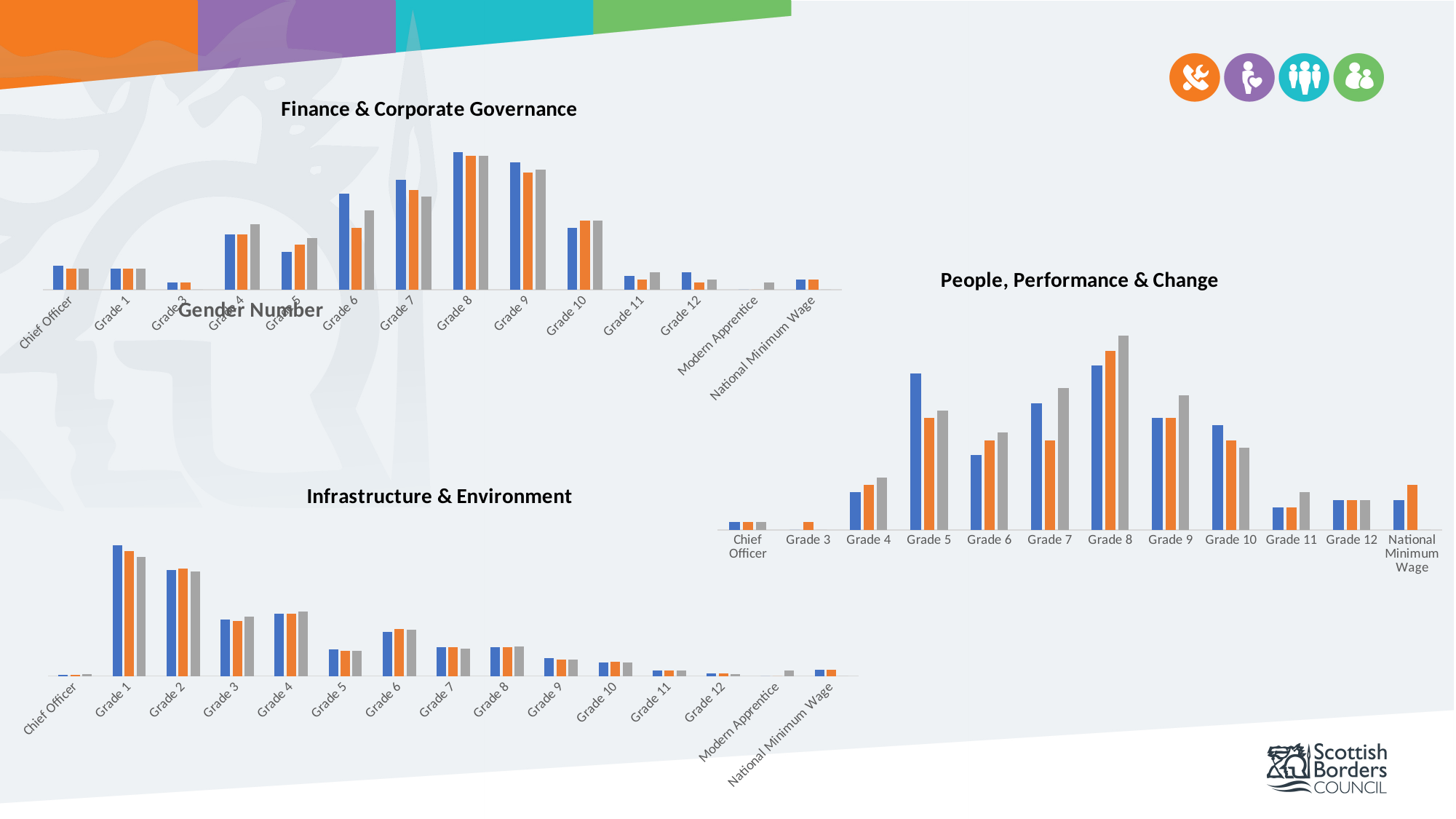
What kind of chart is the 'Finance & Corporate Governance' chart? bar chart In the 'Finance & Corporate Governance' chart, which is larger, the blue bar for Grade 8 or the blue bar for Grade 10? Grade 8 In the 'Finance & Corporate Governance' chart, which category has the tallest bar? Grade 8 How many charts are shown on the slide? 3 In the 'Infrastructure & Environment' chart, how many categories are shown on the x axis? 15 In the 'People, Performance & Change' chart, which is larger, the blue bar for Grade 5 or the blue bar for Grade 6? Grade 5 In the 'People, Performance & Change' chart, which category has the tallest bar? Grade 8 In the 'Infrastructure & Environment' chart, which is larger, the blue bar for Grade 1 or the blue bar for Grade 5? Grade 1 In the 'Infrastructure & Environment' chart, which category has the tallest bar? Grade 1 In the 'People, Performance & Change' chart, how many categories are shown on the x axis? 12 In the 'Infrastructure & Environment' chart, do the values generally rise or fall from Grade 1 to Grade 12? fall In the 'Finance & Corporate Governance' chart, how many categories are shown on the x axis? 14